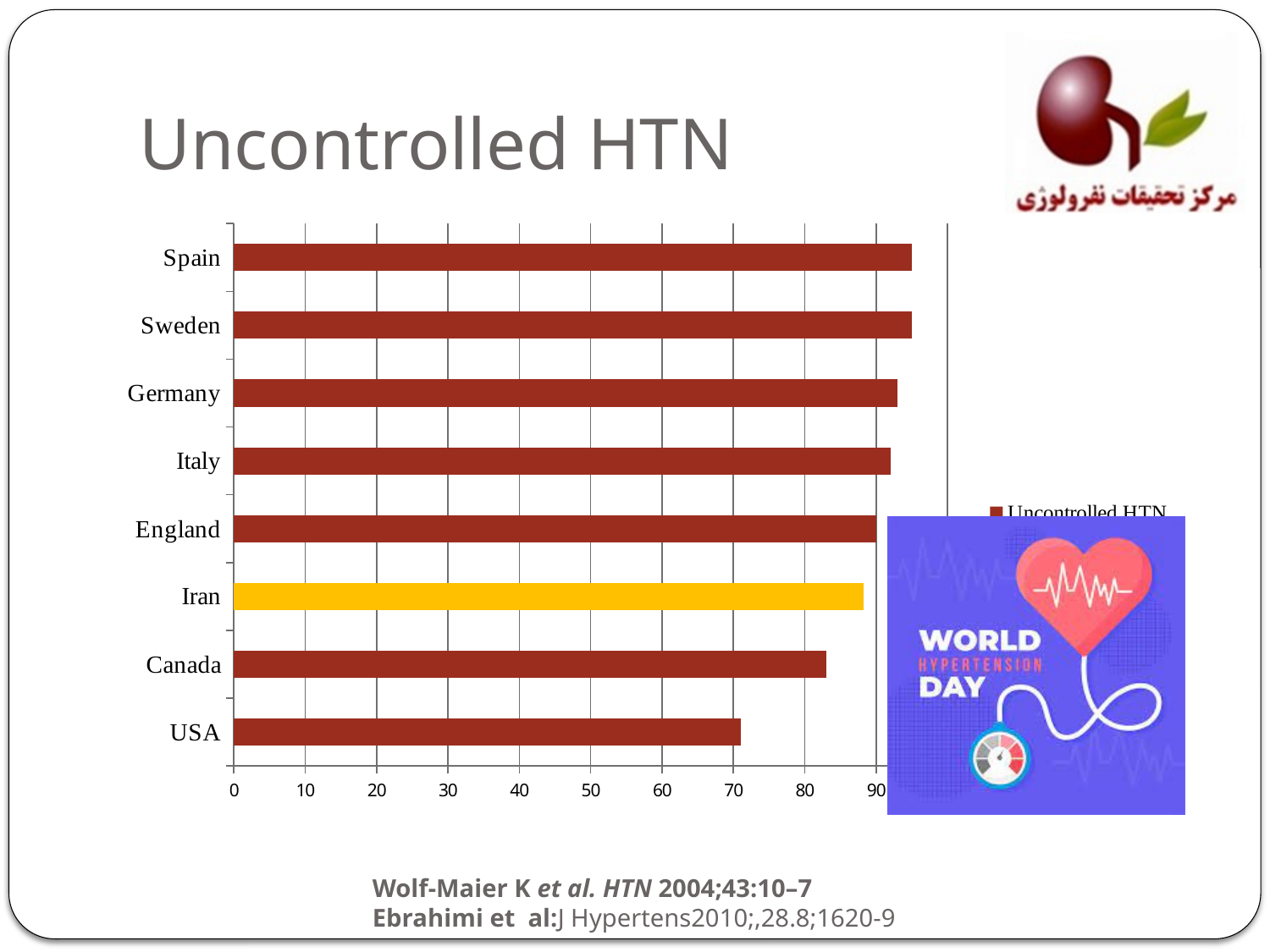
Is the value for Canada greater or less than 90? less What kind of chart is shown on the slide? bar chart What series name does the legend show? Uncontrolled HTN Is the value for Spain greater or less than 90? greater Is the value for Iran greater or less than 80? greater Which country's bar is shown in yellow instead of dark red? Iran Which has a larger value, Iran or Canada? Iran Which country has the lowest value for uncontrolled HTN? USA How many countries are plotted in the chart? 8 Which has a larger value, USA or Canada? Canada